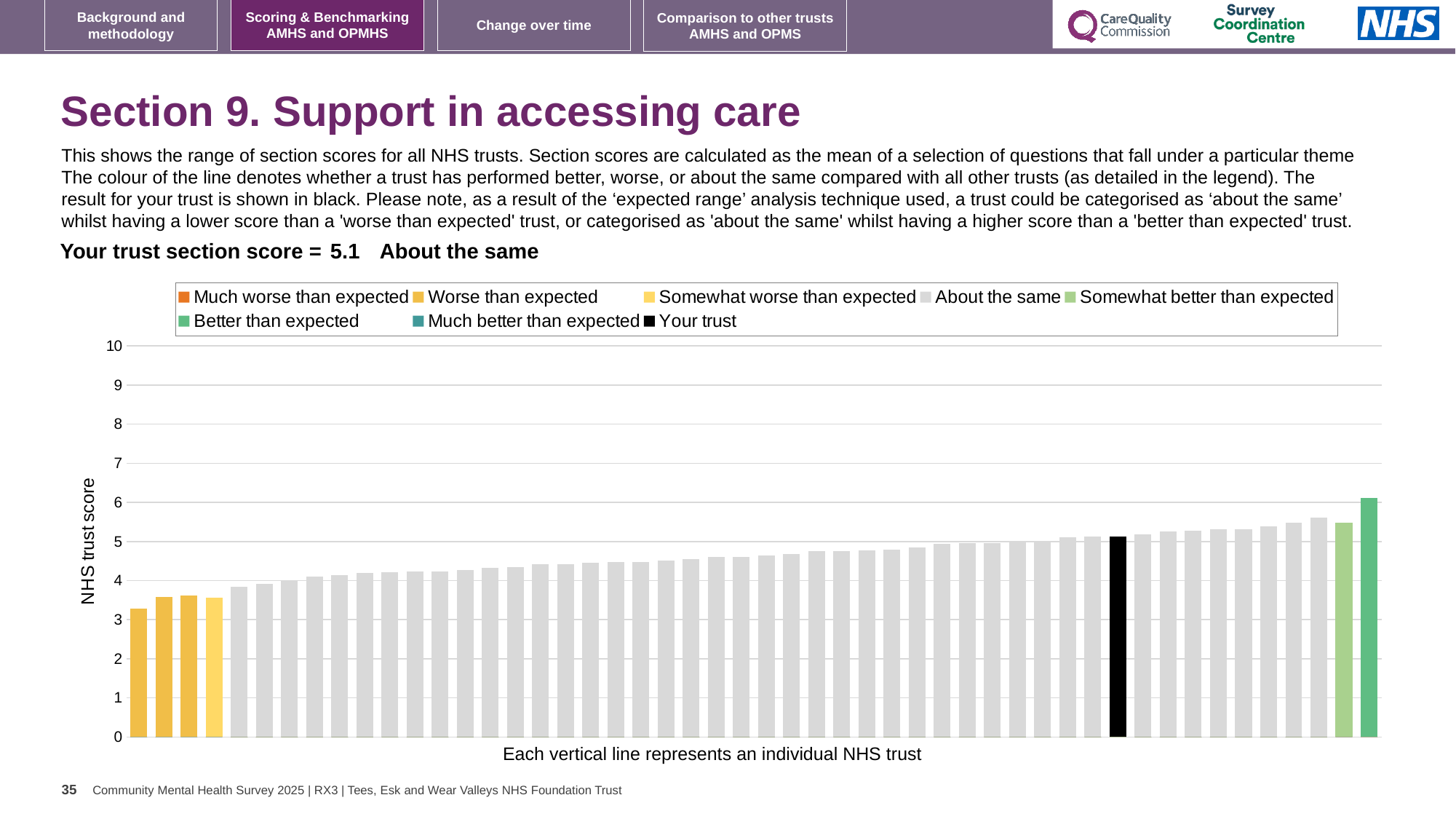
What type of chart is shown on the slide? bar chart What is the section score for your trust, as printed on the slide? 5.1 Which legend category does your trust fall into according to the slide? About the same What is the label on the vertical axis of the chart? NHS trust score Is the value of the tallest bar greater or less than 7? less Which legend category does the shortest bar belong to? Worse than expected Do the bar values rise or fall from left to right along the x axis? rise Which legend category does the tallest bar belong to? Better than expected Is the value for your trust (the black bar) greater or less than 4? greater How many entries does the chart legend list? 8 How many bars are coloured as 'Worse than expected' (yellow)? 3 Is the value of the leftmost (lowest) bar greater or less than 4? less